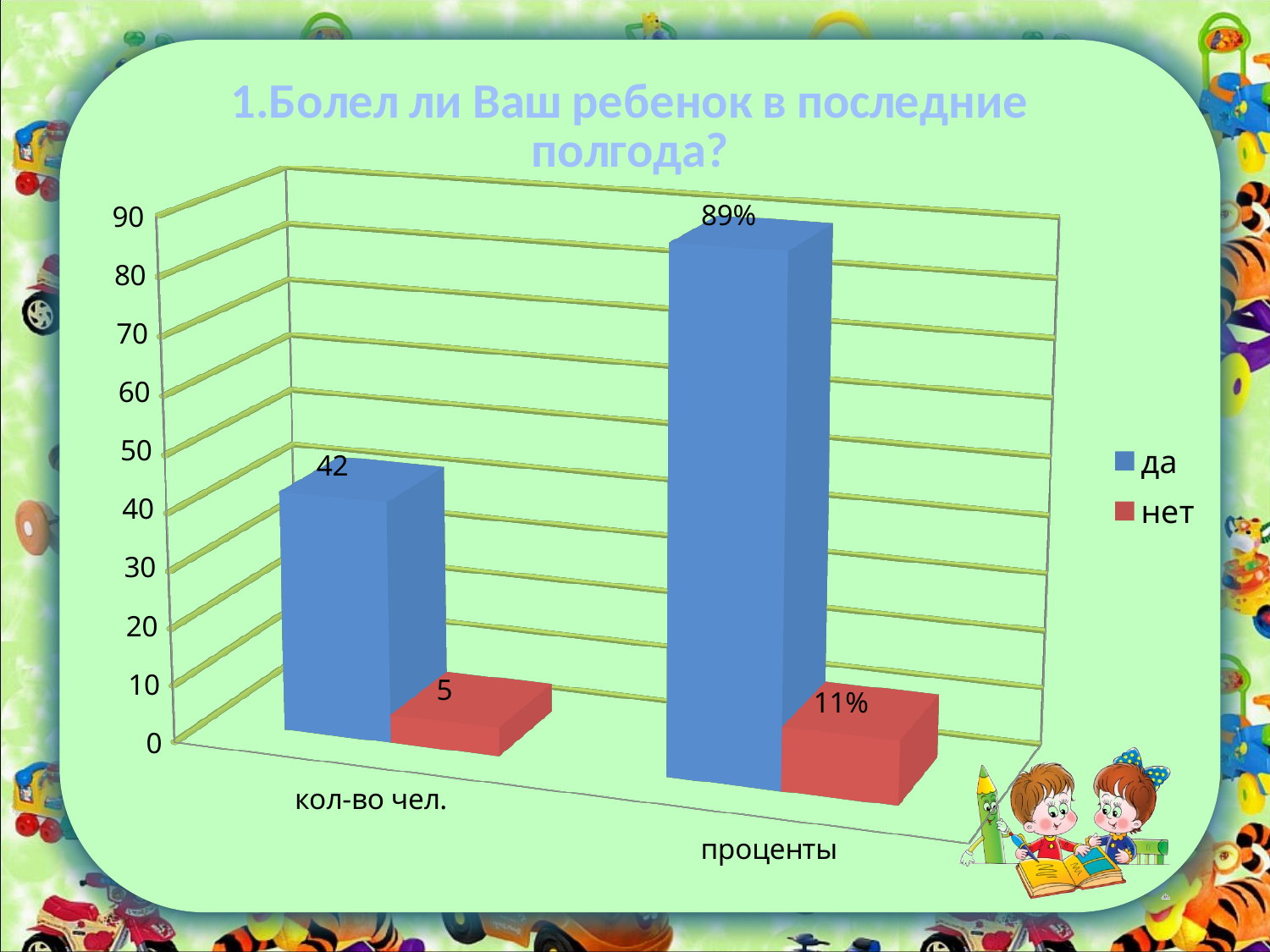
What kind of chart is shown on the slide? bar chart What is the value for "нет" in the "кол-во чел." category? 5 Is the "да" value in the "кол-во чел." category larger or smaller than the "нет" value in the same category? larger Which series has the higher value in the "проценты" category? да What is the value for "нет" in the "проценты" category? 11% How many categories are shown on the x axis? 2 Which series has the lowest value in the "кол-во чел." category? нет What is the value for "да" in the "проценты" category? 89% What is the difference between the "да" and "нет" values in the "кол-во чел." category? 37 What is the value for "да" in the "кол-во чел." category? 42 How many series does the legend list? 2 What colour are the bars for the "нет" series? red